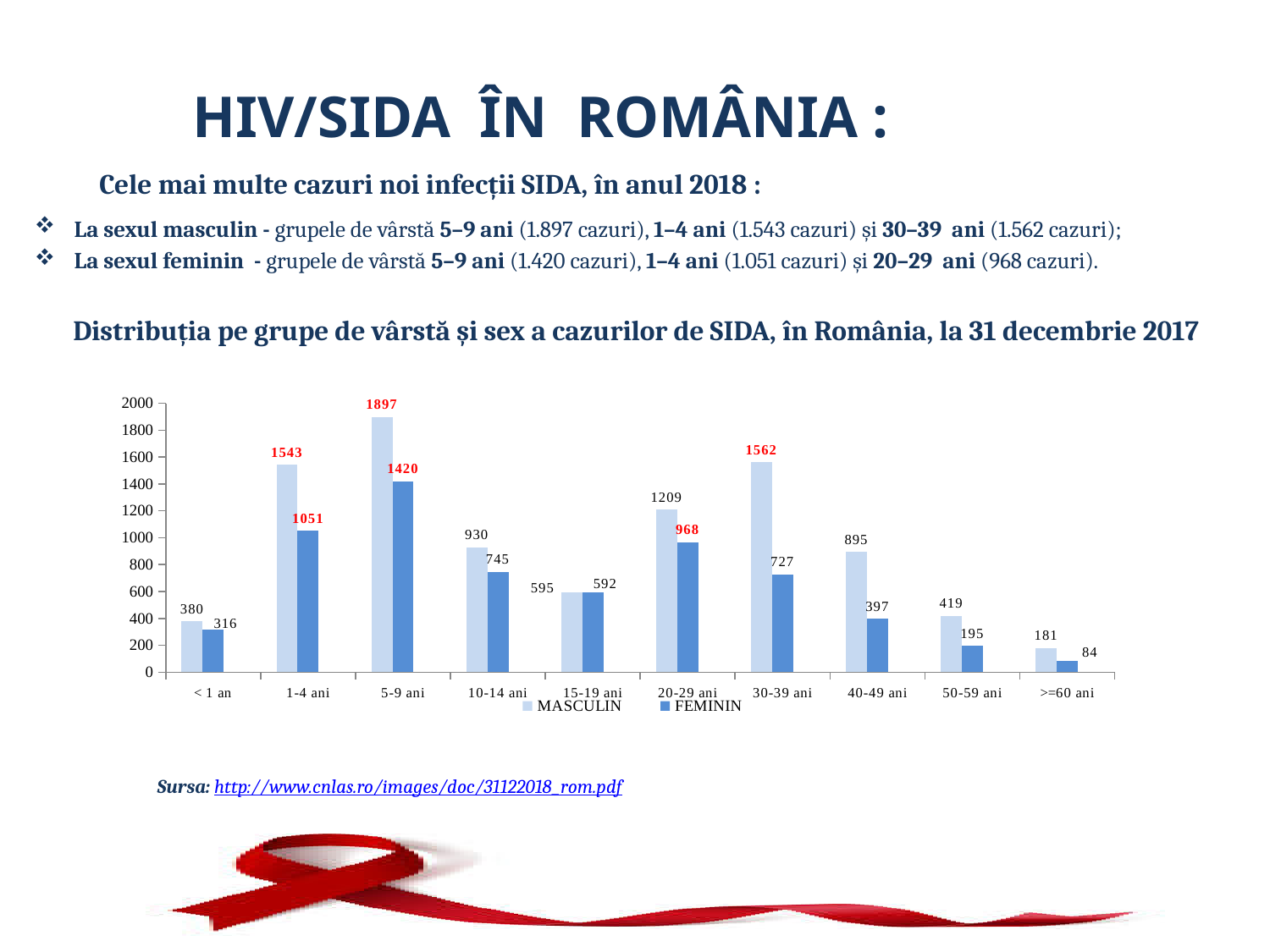
Do the FEMININ values rise or fall from the 30-39 ani group to the >=60 ani group? fall How many age groups are shown on the x axis? 10 What are the two series named in the legend? MASCULIN and FEMININ Which is larger for the 15-19 ani age group, the MASCULIN value or the FEMININ value? MASCULIN Which age group has the lowest FEMININ value? >=60 ani Which age group has the highest MASCULIN value? 5-9 ani What is the difference between the MASCULIN and FEMININ values for the 30-39 ani age group? 835 What is the MASCULIN value for the 5-9 ani age group? 1897 What kind of chart is shown on the slide? bar chart How many series does the legend list? 2 What is the FEMININ value for the 20-29 ani age group? 968 What is the MASCULIN value for the 40-49 ani age group? 895